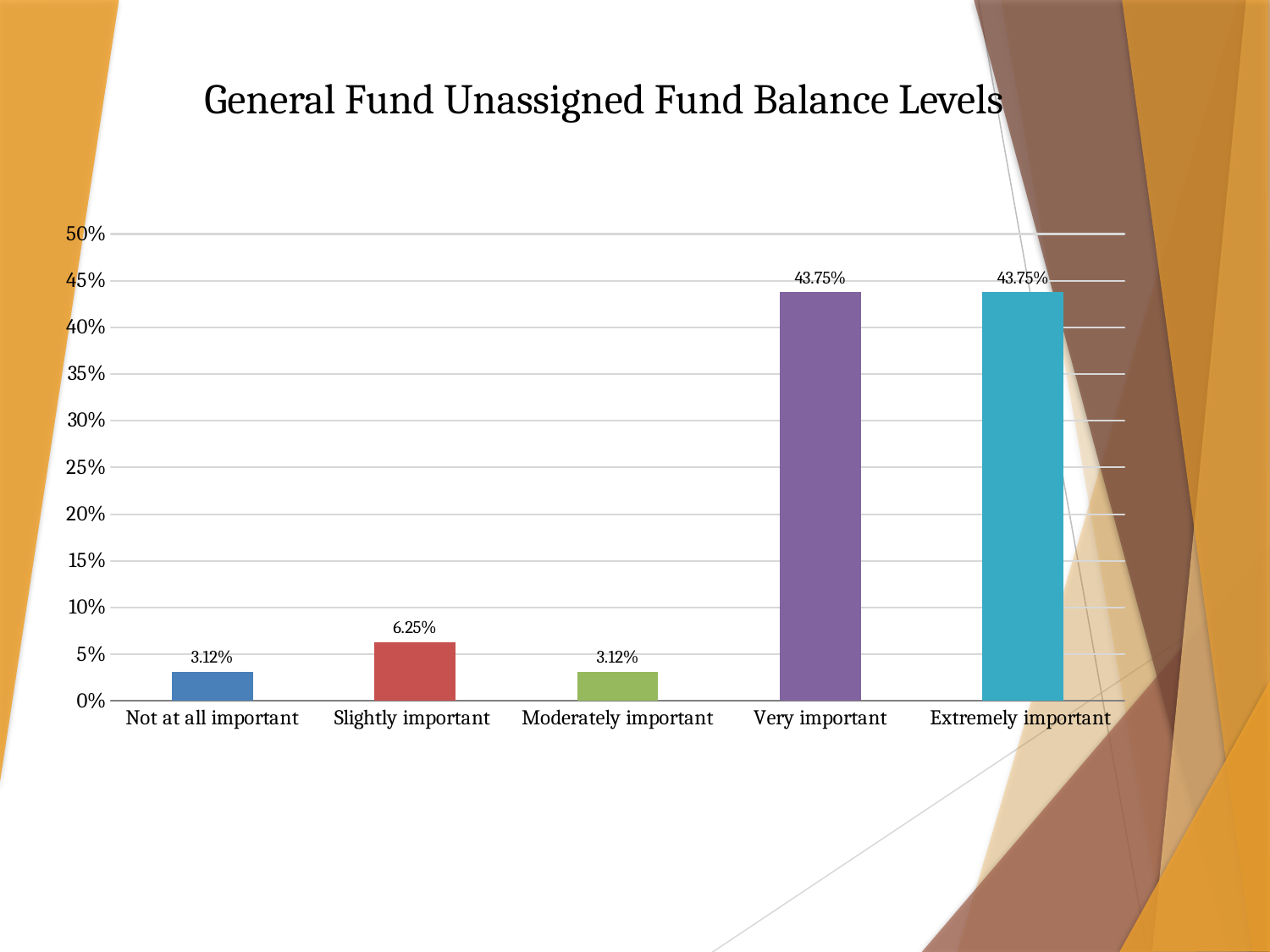
What is the value for Very important? 43.75% What is the difference between the values for Slightly important and Not at all important? 3.13% Is the value for Slightly important greater or less than 10%? less What kind of chart is shown on the slide? bar chart What is the title of the chart? General Fund Unassigned Fund Balance Levels How many categories are shown on the x axis? 5 What is the value for Not at all important? 3.12% Which category has the lowest value, Slightly important or Moderately important? Moderately important What is the value for Moderately important? 3.12% Is the value for Extremely important greater or less than 40%? greater What is the value for Slightly important? 6.25% What is the difference between the values for Very important and Slightly important? 37.5%